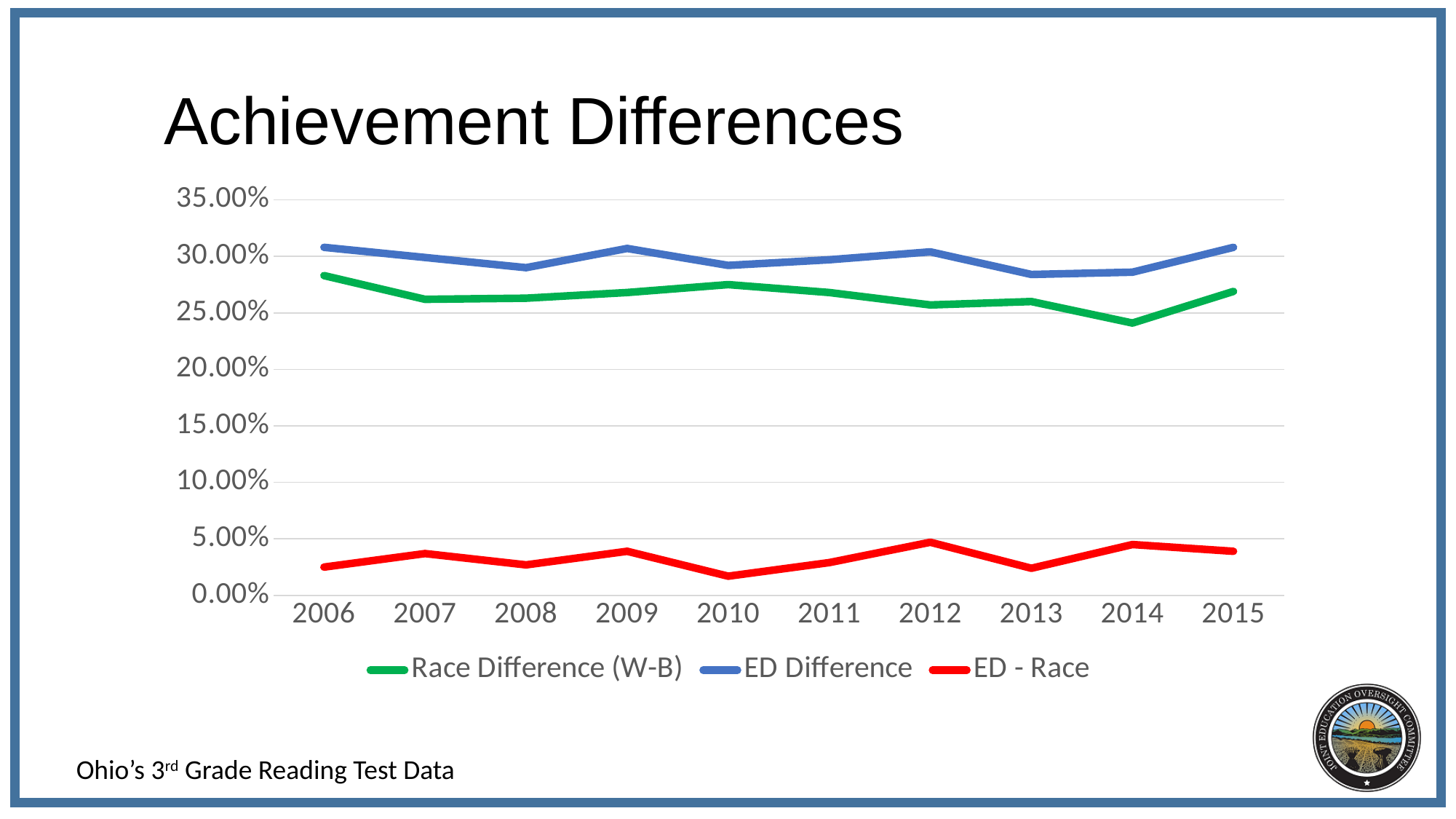
What is the title of the chart? Achievement Differences Is the value for ED - Race in 2010 greater or less than 5.00%? less What kind of chart is shown on the slide? line chart How many series does the legend list? 3 What colour is the line for ED - Race? red Which year has the highest value for Race Difference (W-B)? 2006 In 2010, which series has the larger value: ED Difference or Race Difference (W-B)? ED Difference How many years are shown along the x axis? 10 Which year has the lowest value for Race Difference (W-B)? 2014 Which year has the lowest value for ED - Race? 2010 Is the value for ED Difference in 2006 greater or less than 30.00%? greater Is the value for Race Difference (W-B) in 2014 greater or less than 25.00%? less